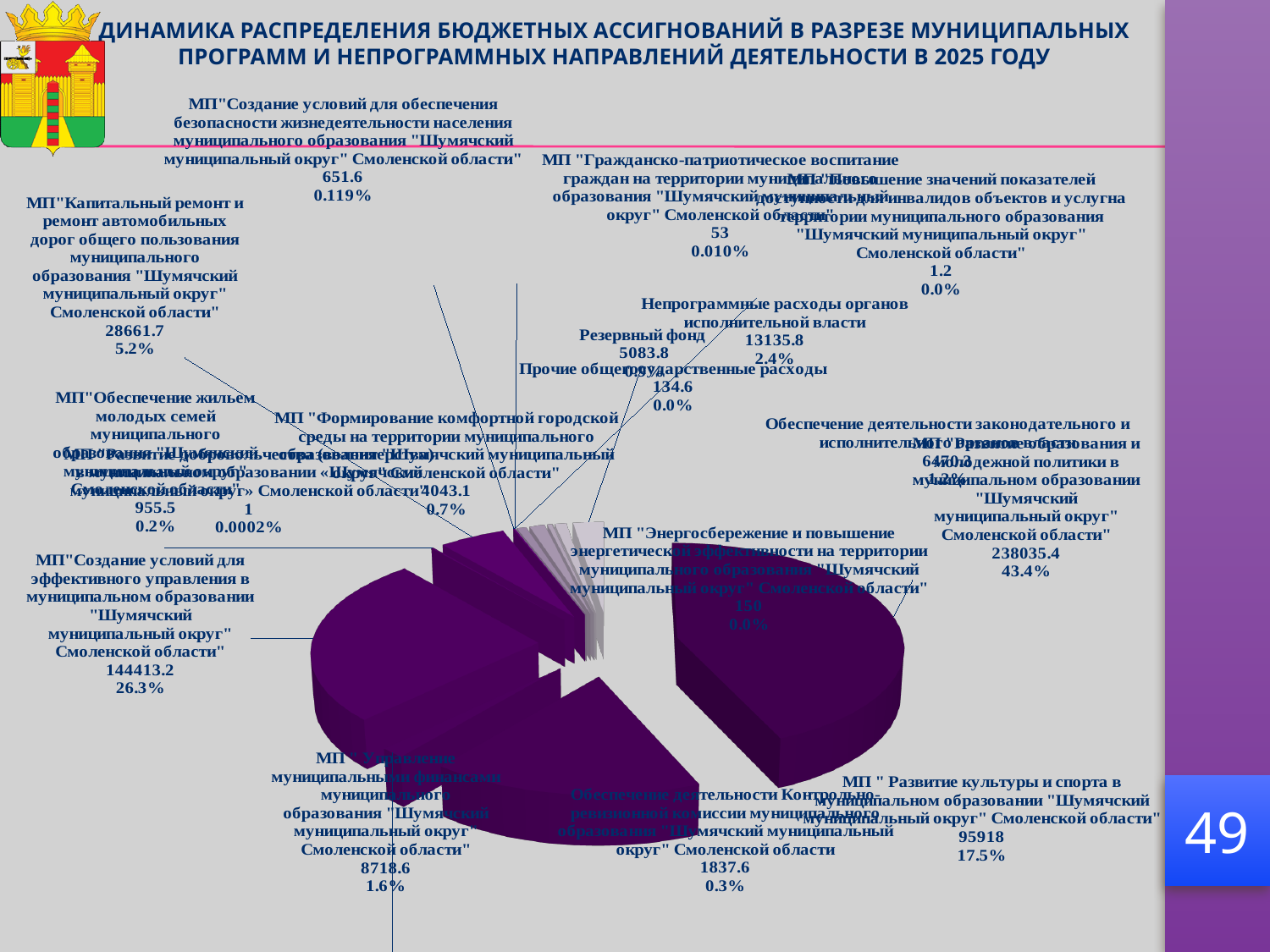
What is the value shown for МП "Энергосбережение и повышение энергетической эффективности"? 150 What is the value shown for МП "Создание условий для эффективного управления"? 144413.2 What is the value shown for Непрограммные расходы органов исполнительной власти? 13135.8 What is the value shown for МП "Развитие культуры и спорта"? 95918 What is the difference between the value for МП "Управление муниципальными финансами" (8718.6) and the value for Обеспечение деятельности Контрольно-ревизионной комиссии (1837.6)? 6881 Which category has the smallest value on the chart? МП "Развитие добровольчества" What percentage is shown for МП "Капитальный ремонт и ремонт автомобильных дорог общего пользования"? 5.2% What share of the budget does the programme МП "Развитие образования и молодежной политики" account for? 43.4% Which category has the largest share of the pie? МП "Развитие образования и молодежной политики" Which is larger: the value for МП "Развитие культуры и спорта" or the value for МП "Создание условий для эффективного управления"? МП "Создание условий для эффективного управления" What kind of chart is shown on the slide? pie chart What percentage is shown for МП "Гражданско-патриотическое воспитание граждан"? 0.010%